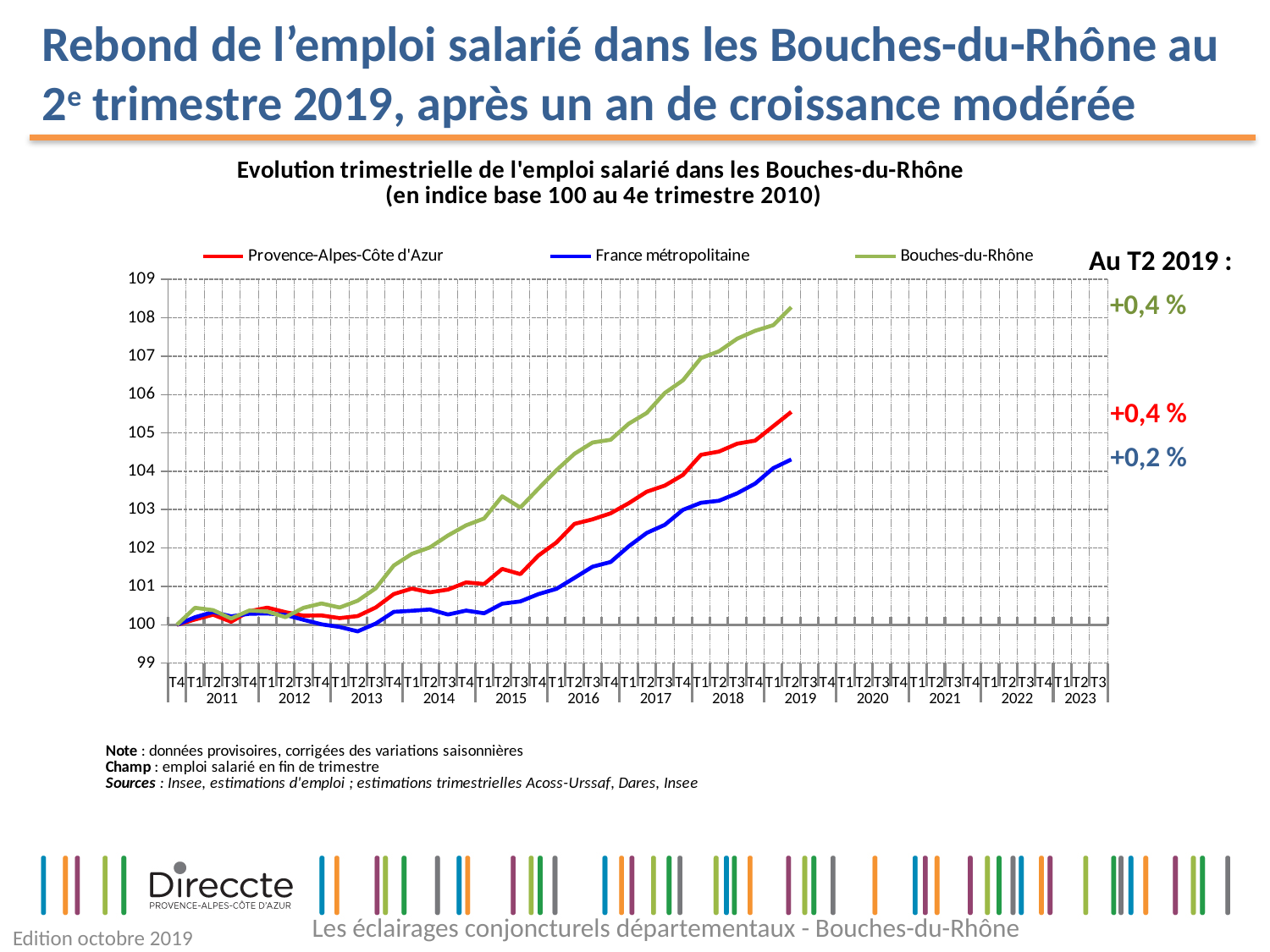
How many series does the legend list? 3 What kind of chart is shown on the slide? line chart Which series has the highest index value at T2 2019? Bouches-du-Rhône Which series has the lowest index value at T2 2019? France métropolitaine What is the base period of the index (base 100) used in the chart? 4e trimestre 2010 What quarterly change is shown for Bouches-du-Rhône at T2 2019? +0,4 % Is the index value for France métropolitaine at T2 2019 greater or less than 105? less Is the index value for Bouches-du-Rhône at T2 2019 greater or less than 107? greater What quarterly change is shown for France métropolitaine at T2 2019? +0,2 % Is the index value for Provence-Alpes-Côte d'Azur at T2 2019 greater or less than 104? greater Which series are listed in the legend? Provence-Alpes-Côte d'Azur, France métropolitaine, Bouches-du-Rhône At T2 2019, which is larger: the index for Provence-Alpes-Côte d'Azur or for France métropolitaine? Provence-Alpes-Côte d'Azur